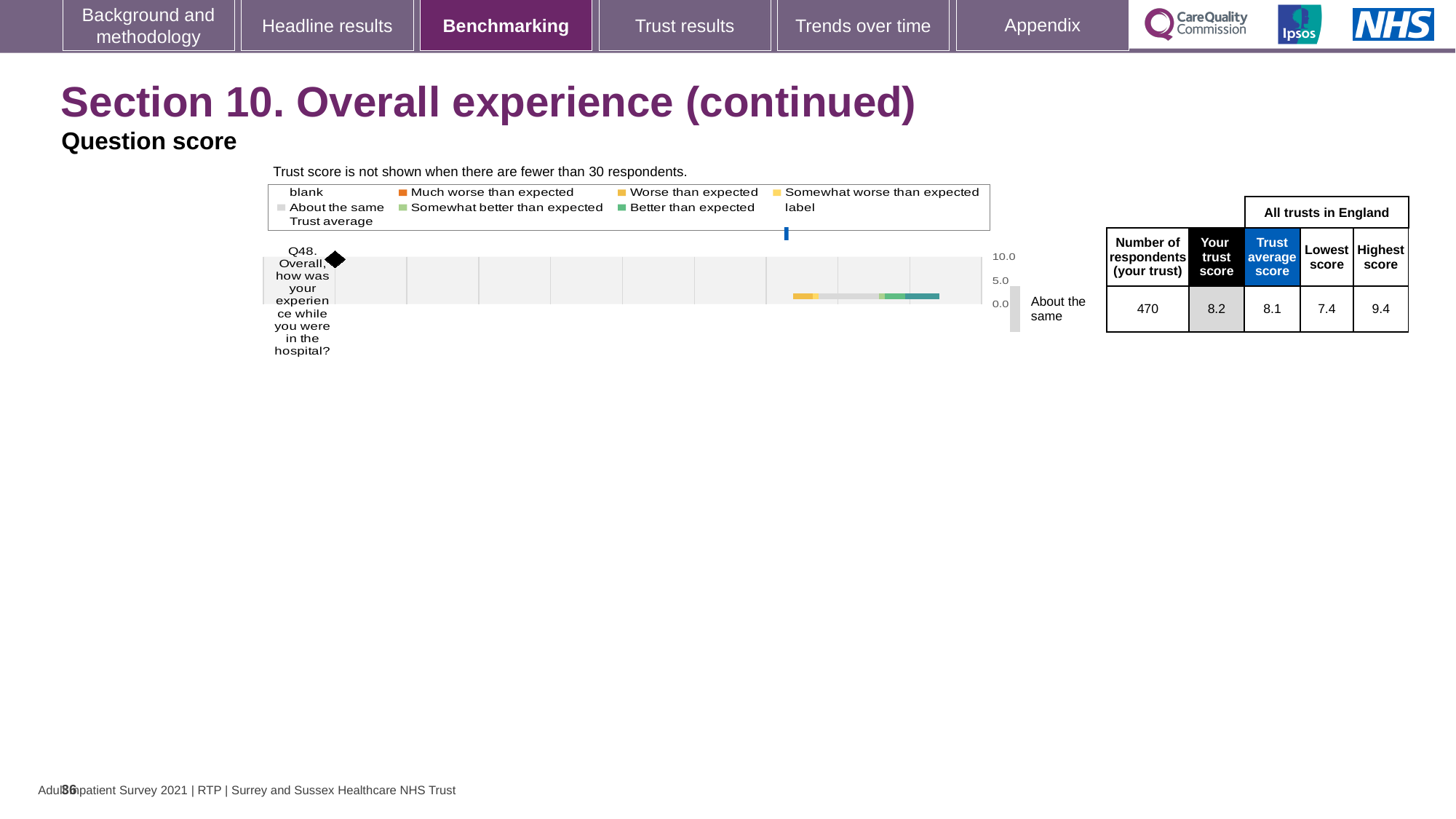
What is the trust score for Q48 (Overall, how was your experience while you were in the hospital?) shown in the table? 8.2 What is the lowest score among all trusts in England for Q48? 7.4 How many questions are plotted on the chart? 1 How is the trust's result for Q48 categorised relative to expectations? About the same What is the difference between the trust score and the trust average score for Q48? 0.1 How many respondents from the trust answered Q48? 470 What is the difference between the highest score and the lowest score for Q48? 2.0 What is the trust average score for Q48 shown in the table? 8.1 What kind of chart is used to show the Q48 benchmarking result? Bar chart Which is larger for Q48: the trust score or the trust average score? Trust score Which legend entry is shown in orange? Much worse than expected What is the highest score among all trusts in England for Q48? 9.4